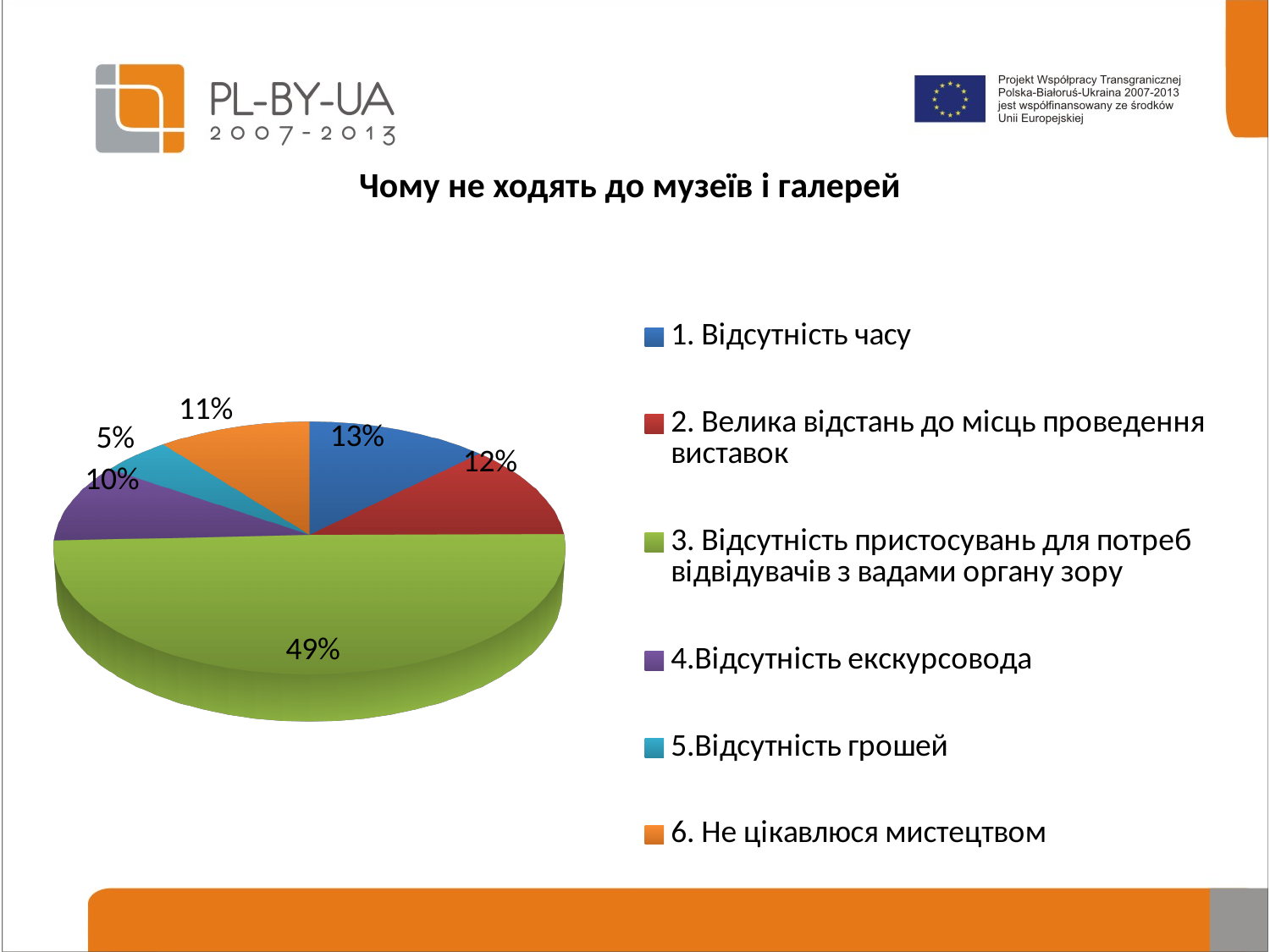
What share of the pie is "4.Відсутність екскурсовода"? 10% What share of the pie is "3. Відсутність пристосувань для потреб відвідувачів з вадами органу зору"? 49% Which category has the smallest share of the pie? 5.Відсутність грошей What is the title of the chart? Чому не ходять до музеїв і галерей What kind of chart is shown on the slide? Pie chart Which category has the largest share of the pie? 3. Відсутність пристосувань для потреб відвідувачів з вадами органу зору What share of the pie is "2. Велика відстань до місць проведення виставок"? 12% What share of the pie is "5.Відсутність грошей"? 5% What share of the pie is "6. Не цікавлюся мистецтвом"? 11% How many categories does the legend list? 6 What share of the pie is "1. Відсутність часу"? 13% What is the difference in percentage points between the share for "1. Відсутність часу" and the share for "5.Відсутність грошей"? 8